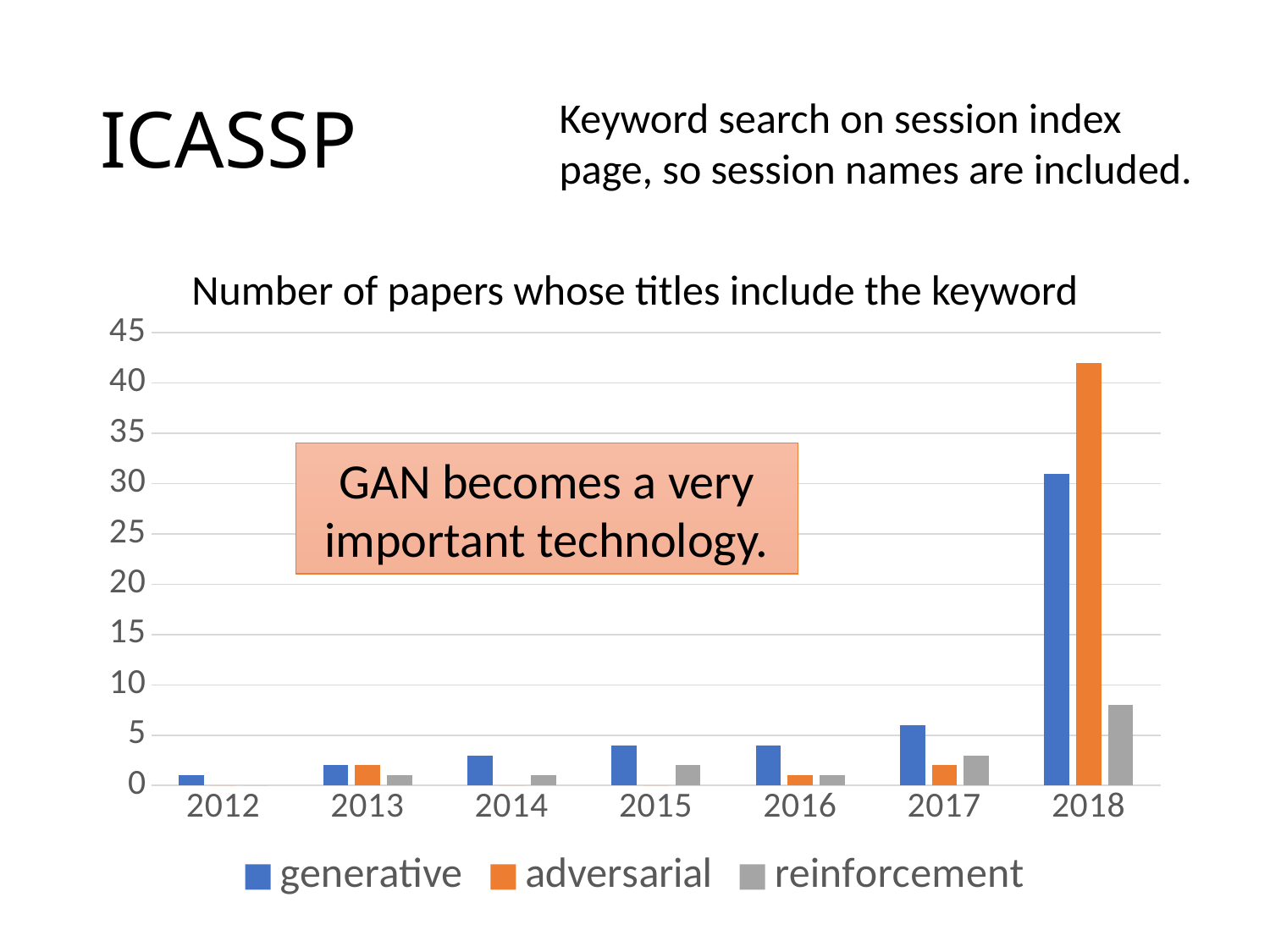
What is the title of the chart? Number of papers whose titles include the keyword How many series does the legend list? 3 Does the value for generative generally rise or fall from 2012 to 2018? rise Which year has the highest value for adversarial? 2018 What kind of chart is shown on the slide? bar chart Is the value for reinforcement in 2018 greater or less than 10? less Is the value for adversarial in 2018 greater or less than 40? greater Is the value for generative in 2018 greater or less than 35? less Which year has the highest value for generative? 2018 How many years are shown on the x axis? 7 In 2018, which series has the larger value, generative or adversarial? adversarial In 2017, which series has the larger value, generative or reinforcement? generative